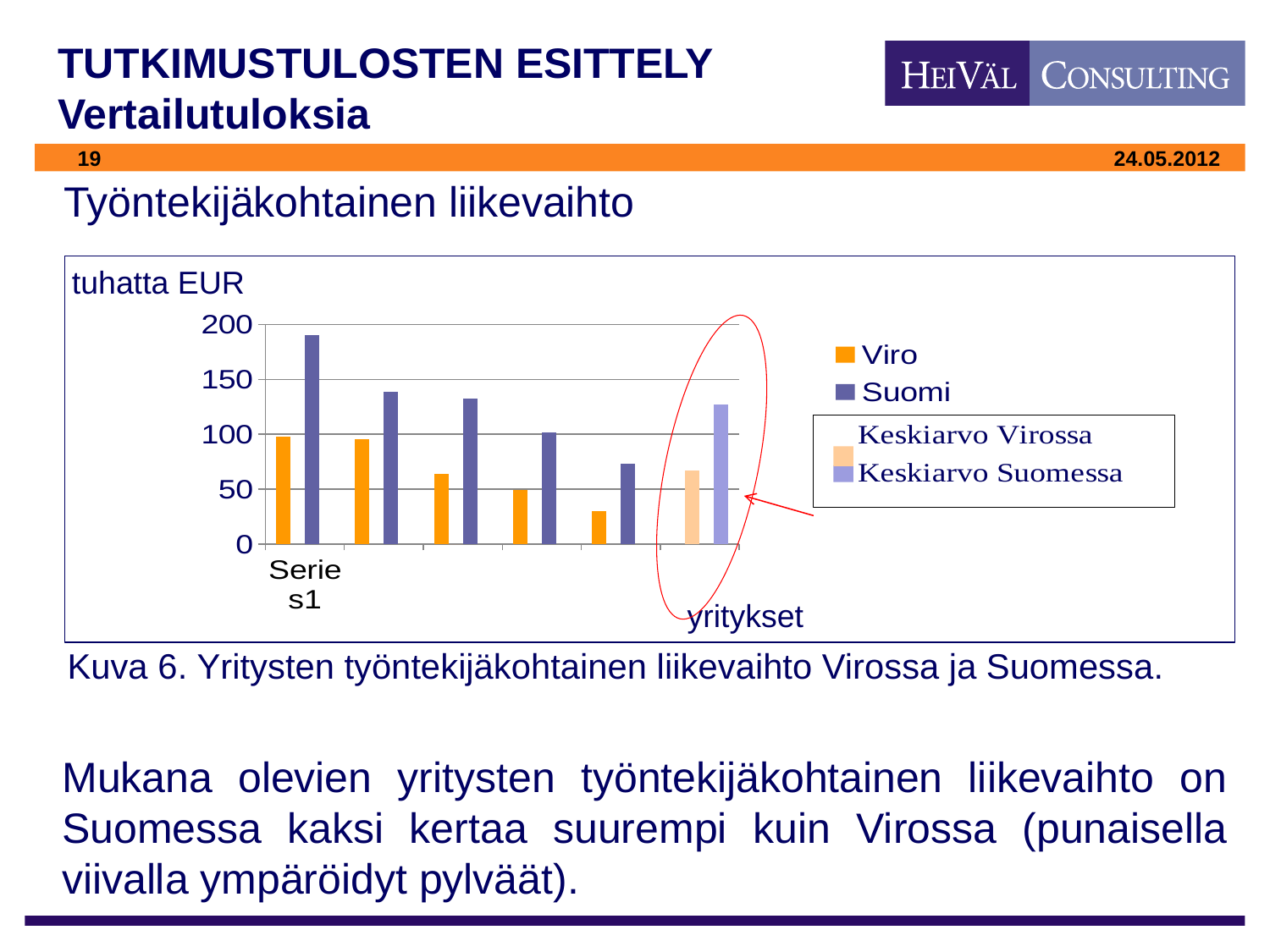
Is the Suomi value for Series1 greater or less than 150? greater How many series does the chart legend list? 4 Do the Suomi bars rise or fall from left to right across the five company groups? fall What unit is given for the vertical axis of the chart? tuhatta EUR Is the Keskiarvo Suomessa value greater or less than 100? greater Which is larger, Keskiarvo Virossa or Keskiarvo Suomessa? Keskiarvo Suomessa Is the Viro value for Series1 greater or less than 50? greater How many groups of bars are plotted in the chart? 6 Which series is shown in orange in the chart legend? Viro What kind of chart is shown on the slide? bar chart For Series1, which is larger, the Viro value or the Suomi value? Suomi